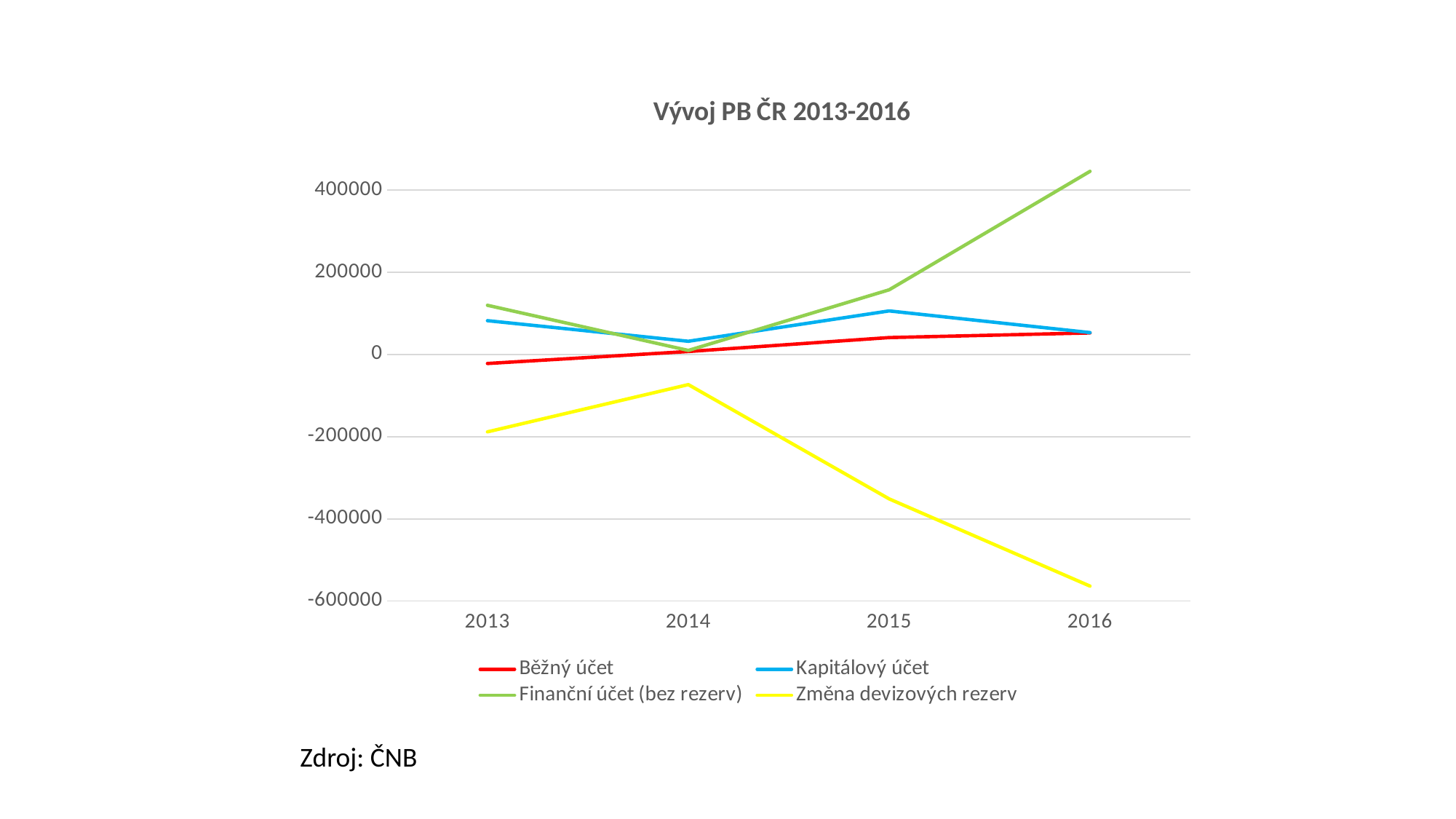
In 2016, which is larger: Finanční účet (bez rezerv) or Kapitálový účet? Finanční účet (bez rezerv) In which year is the Změna devizových rezerv series at its lowest? 2016 In which year is the Finanční účet (bez rezerv) series at its highest? 2016 What is the title of the chart? Vývoj PB ČR 2013-2016 In 2013, which is larger: Kapitálový účet or Běžný účet? Kapitálový účet Is the value for Změna devizových rezerv in 2015 greater or less than -200000? less Is the value for Finanční účet (bez rezerv) in 2016 greater or less than 400000? greater How many years are shown on the x axis? 4 What kind of chart is shown on the slide? line chart Which colour is used for the Změna devizových rezerv series? yellow How many series does the legend list? 4 Does the Běžný účet series rise or fall from 2013 to 2016? rise